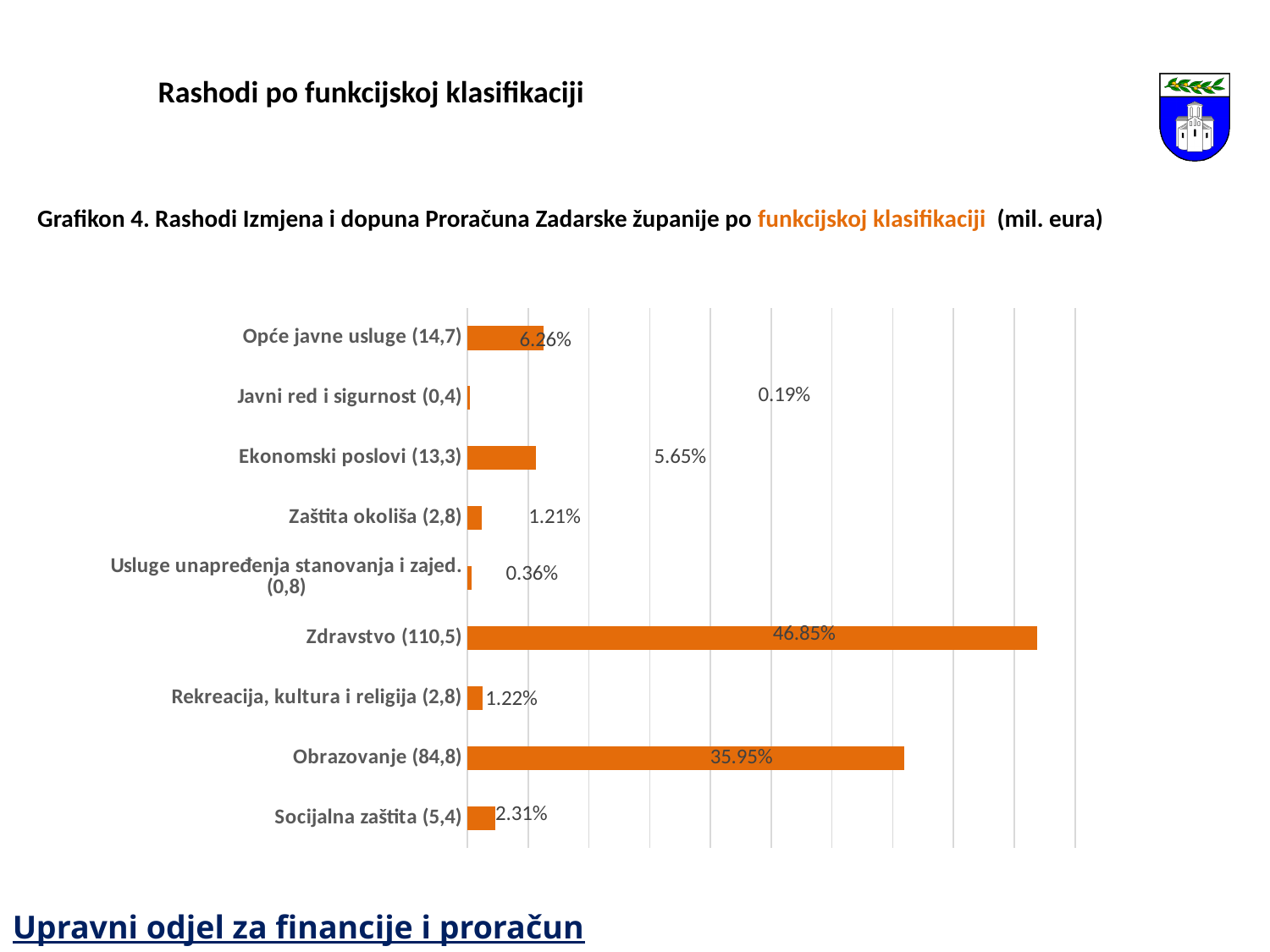
How many categories are plotted in the chart? 9 Which category has the lowest percentage? Javni red i sigurnost (0,4) What type of chart is shown on the slide? bar chart What is the percentage shown for Obrazovanje (84,8)? 35.95% What unit is stated in the chart title for the values in parentheses? mil. eura What is the difference in percentage points between Opće javne usluge (14,7) and Ekonomski poslovi (13,3)? 0.61% What is the percentage shown for Javni red i sigurnost (0,4)? 0.19% What is the percentage shown for Zdravstvo (110,5)? 46.85% Which has a larger percentage, Socijalna zaštita (5,4) or Zaštita okoliša (2,8)? Socijalna zaštita (5,4) What is the difference in percentage points between Zdravstvo (110,5) and Obrazovanje (84,8)? 10.90% What is the percentage shown for Ekonomski poslovi (13,3)? 5.65% Which category has the highest percentage? Zdravstvo (110,5)